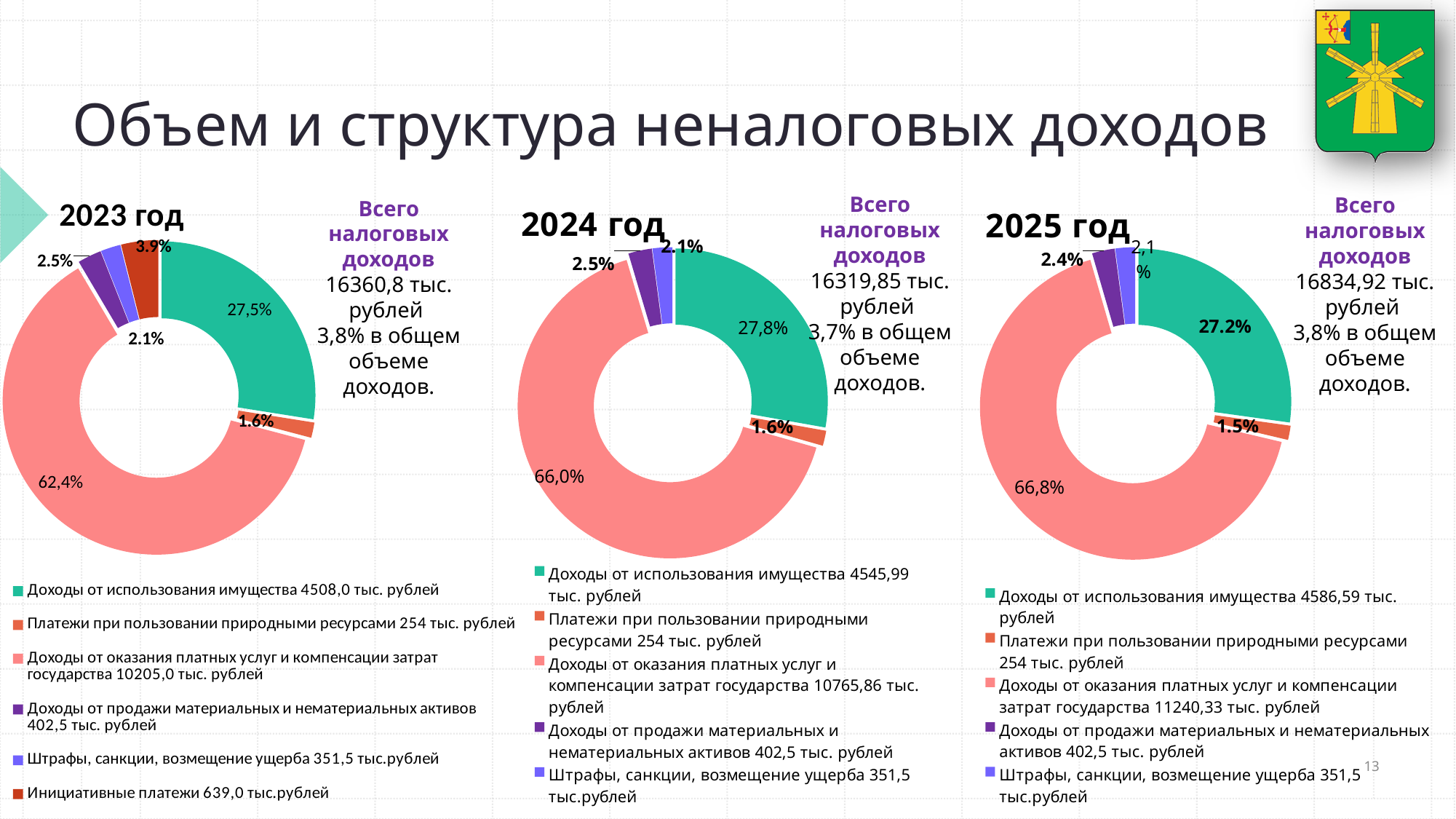
In the 2023 год chart, what share is shown for Доходы от оказания платных услуг и компенсации затрат государства? 62,4% In the 2024 год chart, which is larger: the share for Доходы от использования имущества or the share for Доходы от продажи материальных и нематериальных активов? Доходы от использования имущества In the 2023 год chart, which category has the largest share? Доходы от оказания платных услуг и компенсации затрат государства According to the legend of the 2025 год chart, what amount is given for Доходы от оказания платных услуг и компенсации затрат государства? 11240,33 тыс. рублей In the 2024 год chart, what share is shown for Штрафы, санкции, возмещение ущерба? 2.1% In the 2023 год chart, what share is shown for Инициативные платежи? 3.9% How many categories does the legend of the 2025 год chart list? 5 How many categories does the legend of the 2023 год chart list? 6 In the 2024 год chart, what share is shown for Доходы от использования имущества? 27,8% In the 2025 год chart, which category has the smallest share? Платежи при пользовании природными ресурсами What type of chart is used for 2024 год? Doughnut (pie) chart In the 2025 год chart, what share is shown for Платежи при пользовании природными ресурсами? 1.5%